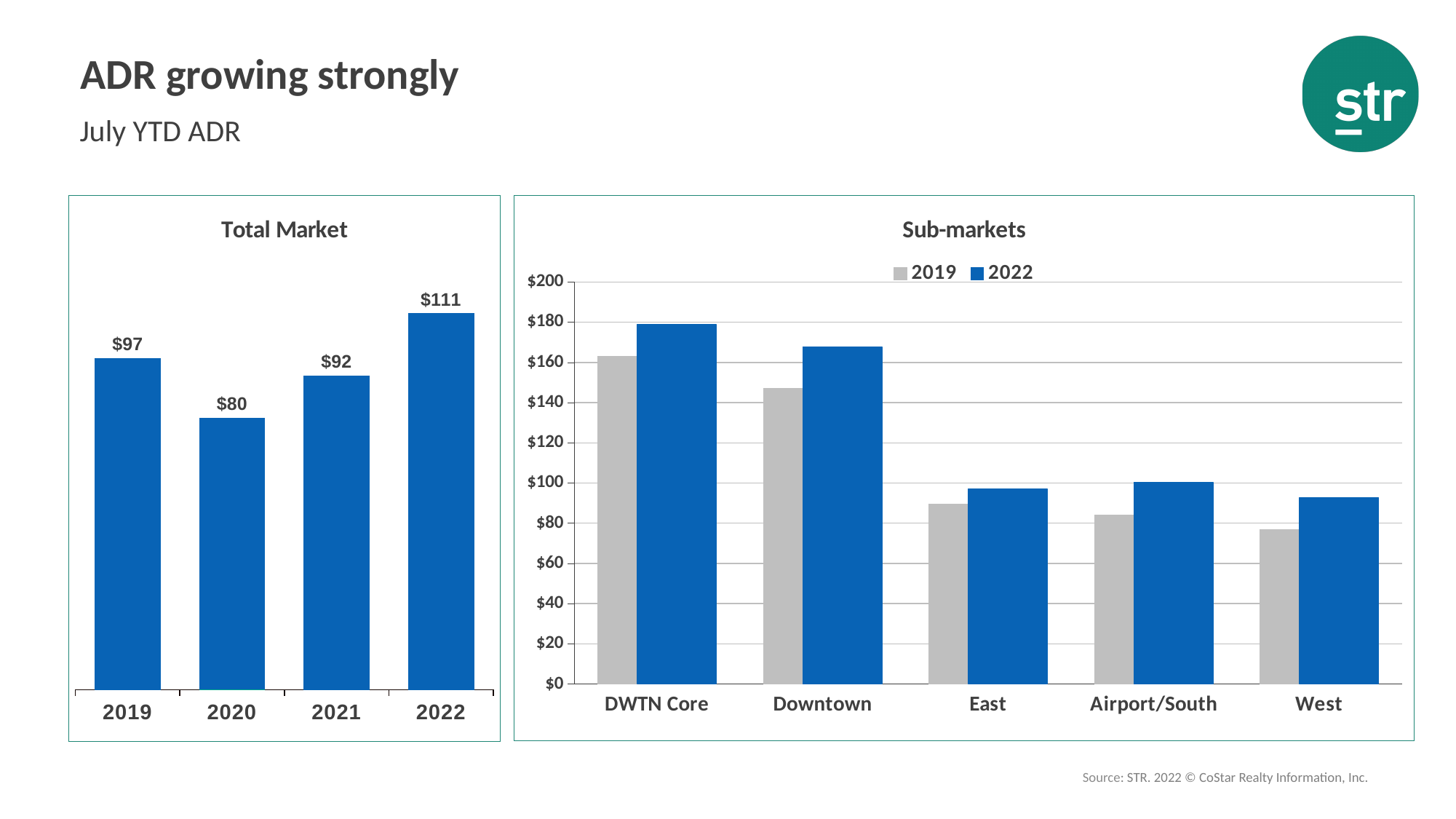
In the Total Market chart, what is the difference between the 2022 and 2019 values? $14 In the Total Market chart, how many years are shown? 4 In the Sub-markets chart, is the 2019 value for West greater or less than $80? less In the Sub-markets chart, which sub-market has the highest 2022 value? DWTN Core In the Sub-markets chart, how many series does the legend list? 2 In the Total Market chart, which year has the highest value? 2022 What kind of chart is the Sub-markets chart? Bar chart In the Sub-markets chart, how many sub-markets are shown on the x axis? 5 In the Total Market chart, what is the value for 2020? $80 In the Total Market chart, what is the value for 2022? $111 In the Total Market chart, which year has the lowest value? 2020 In the Sub-markets chart, is the 2022 value for Downtown greater or less than $160? greater